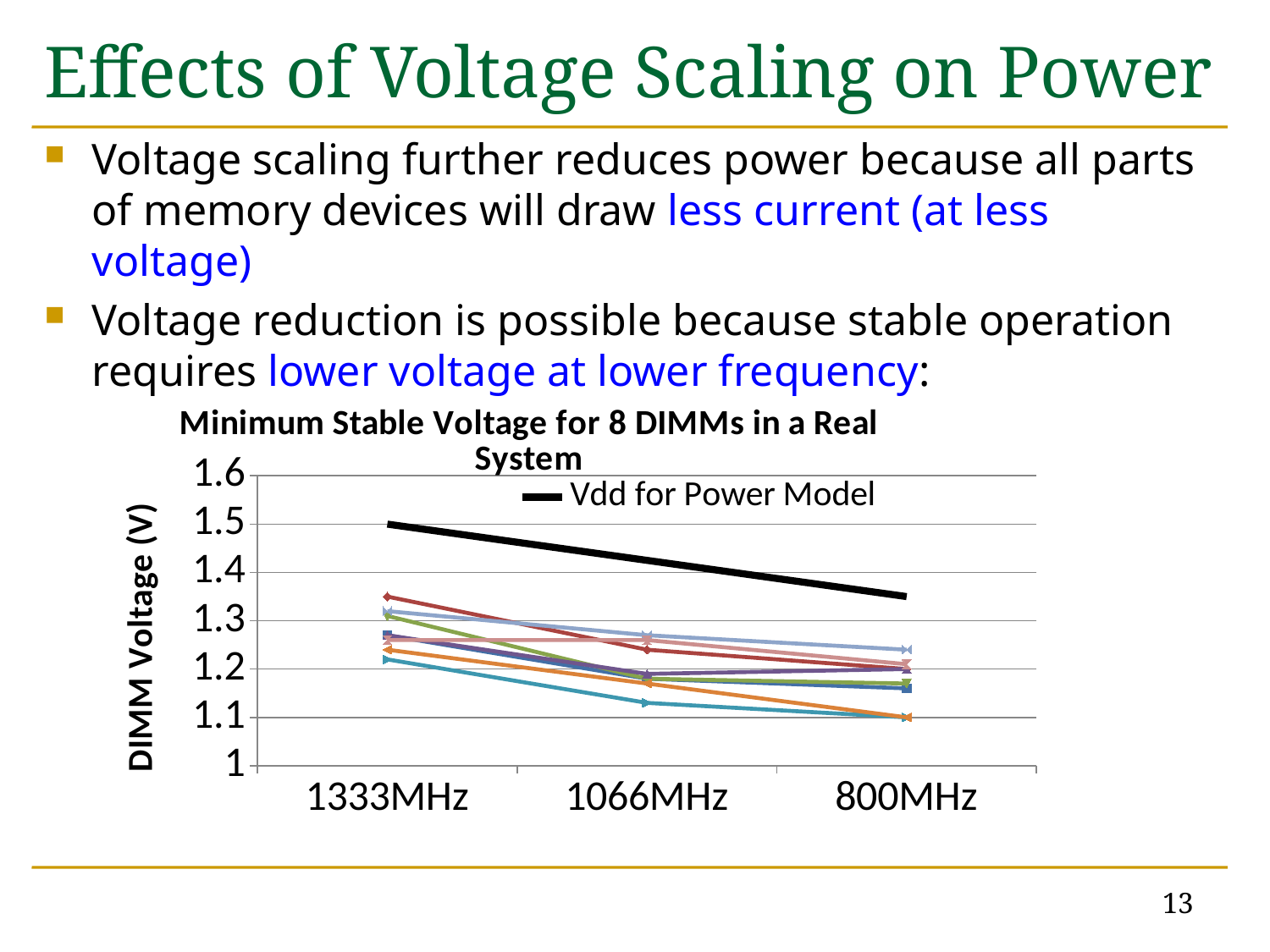
How many series does the legend list? 1 Which is larger for Vdd for Power Model: the value at 1333MHz or the value at 800MHz? 1333MHz What is the title of the chart? Minimum Stable Voltage for 8 DIMMs in a Real System Is the Vdd for Power Model value at 1066MHz greater or less than 1.3? greater How many frequency categories are shown on the x axis? 3 Which series has the highest value at every frequency on the chart? Vdd for Power Model Is the Vdd for Power Model value at 800MHz greater or less than 1.3? greater Does the Vdd for Power Model line rise or fall from 1333MHz to 800MHz? fall What is the label of the y axis? DIMM Voltage (V) What kind of chart is shown on the slide? line chart What is the Vdd for Power Model value at 1333MHz? 1.5 Is the Vdd for Power Model value at 800MHz greater or less than 1.4? less